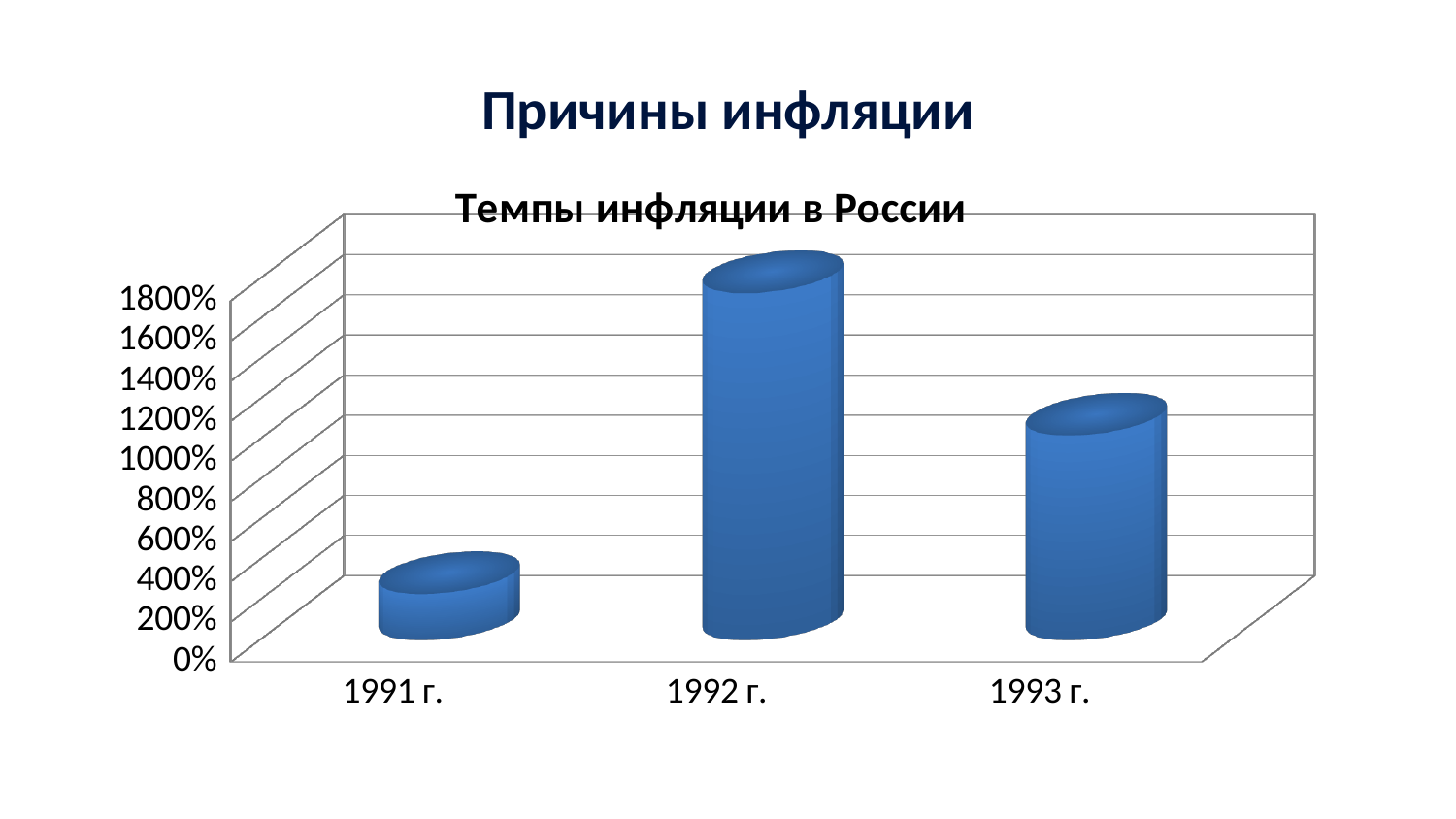
Which year has the lowest inflation rate in the chart? 1991 г. How many categories (years) are shown on the x axis of the chart? 3 What is the highest tick label shown on the vertical axis of the chart? 1800% Which year has the highest inflation rate in the chart? 1992 г. Is the value for 1993 г. greater or less than 600%? greater Which is larger, the value for 1991 г. or the value for 1993 г.? 1993 г. Which is larger, the value for 1992 г. or the value for 1993 г.? 1992 г. Is the value for 1991 г. greater or less than 600%? less What is the title of the chart? Темпы инфляции в России What kind of chart is shown on the slide? bar chart Is the value for 1992 г. greater or less than 1600%? greater